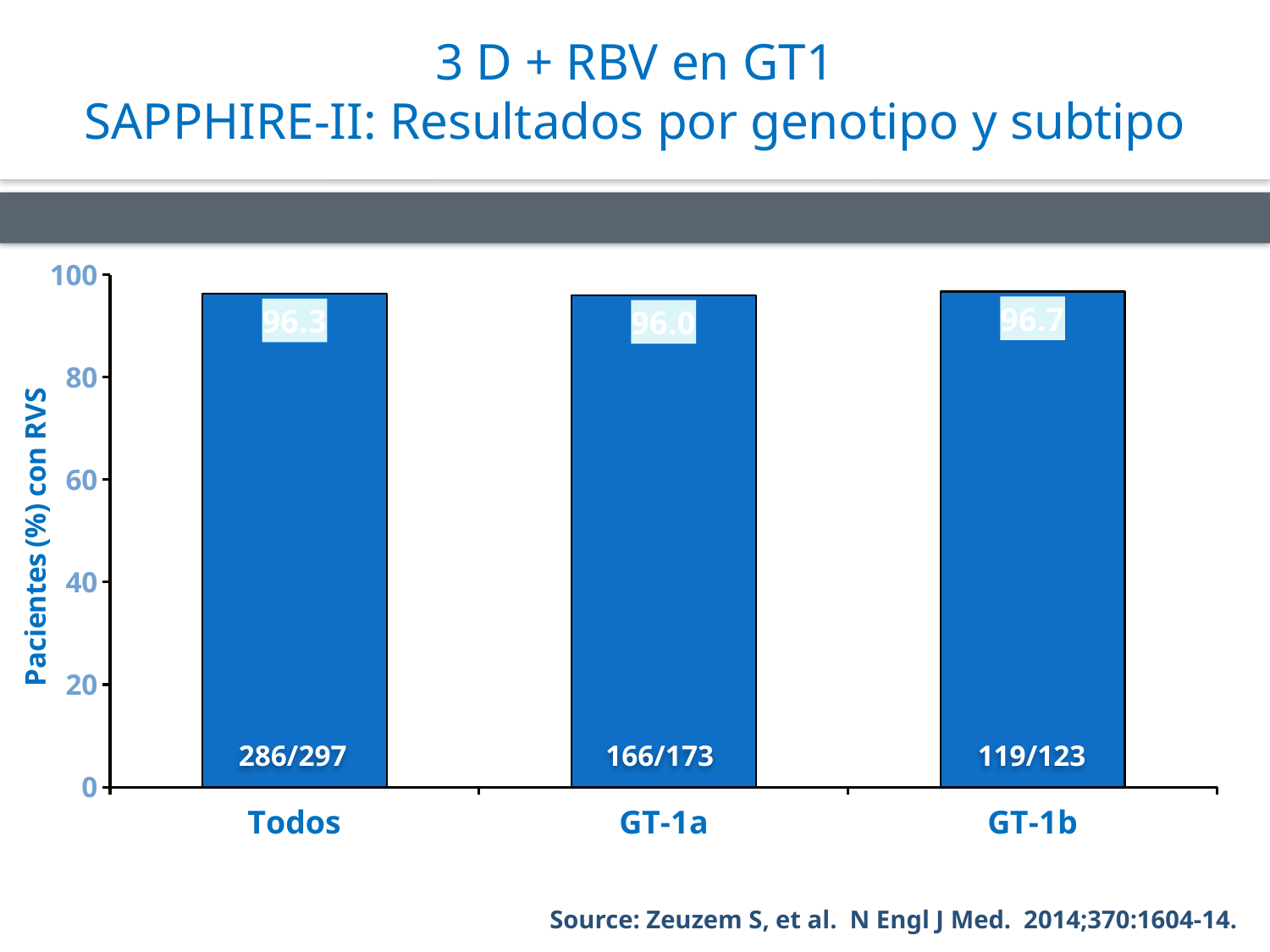
Which is larger, the value for GT-1b or the value for Todos? GT-1b What kind of chart is shown on the slide? bar chart What fraction of patients is printed on the Todos bar? 286/297 Which category has the highest value? GT-1b What is the value for Todos? 96.3 How many categories are shown on the x axis? 3 What is the difference between the values for GT-1b and GT-1a? 0.7 What is the value for GT-1a? 96.0 Is the value for GT-1a greater or less than 80? greater What fraction of patients is printed on the GT-1b bar? 119/123 Which category has the lowest value? GT-1a What is the value for GT-1b? 96.7